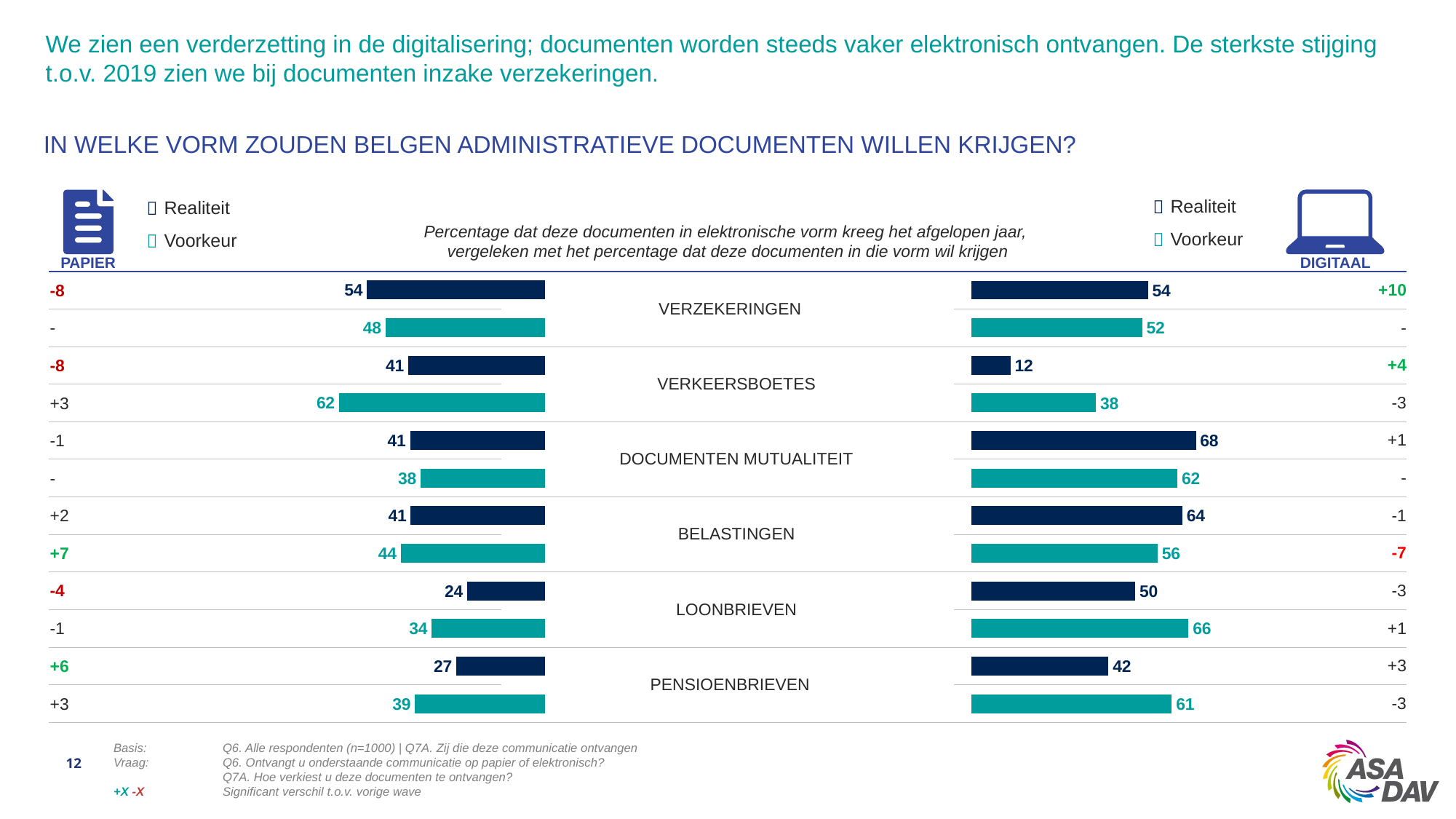
In the PAPIER chart, what is the difference between the Voorkeur and Realiteit values for Verkeersboetes? 21 In the DIGITAAL chart, what is the Realiteit value for Verkeersboetes? 12 How many document categories are shown in the charts? 6 What kind of chart is used for the PAPIER and DIGITAAL data? Bar chart In the DIGITAAL chart, what is the difference between the Realiteit and Voorkeur values for Belastingen? 8 In the DIGITAAL chart, which category has the lowest Realiteit value? Verkeersboetes In the PAPIER chart, what is the Realiteit value for Verzekeringen? 54 In the PAPIER chart, which category has the highest Voorkeur value? Verkeersboetes In the DIGITAAL chart, what is the Voorkeur value for Loonbrieven? 66 In the PAPIER chart, which is larger for Loonbrieven: the Realiteit value or the Voorkeur value? Voorkeur How many series does the legend of the PAPIER chart list? 2 In the DIGITAAL chart, which category has the highest Realiteit value? Documenten Mutualiteit